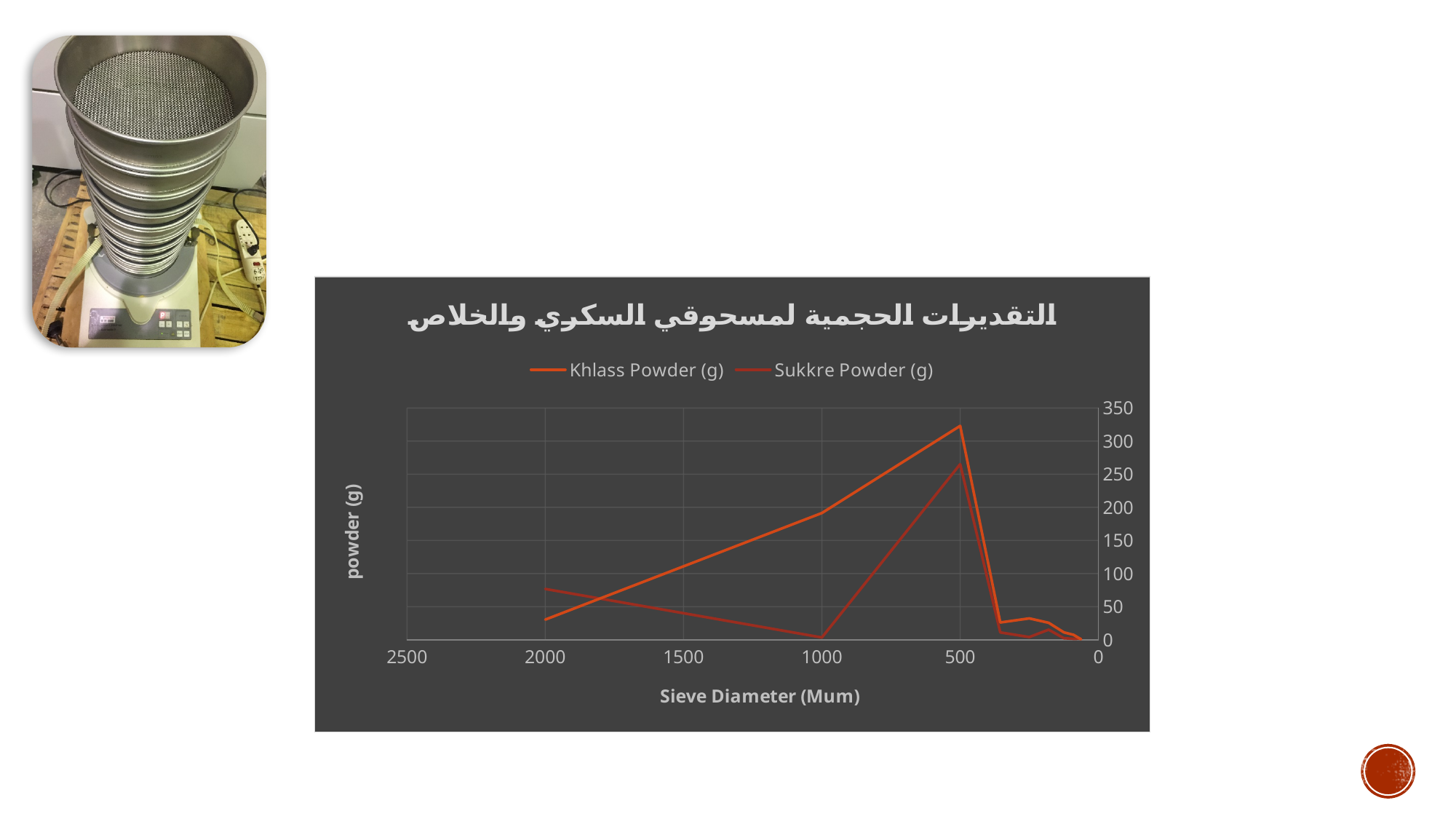
Is the lower of the two peaks at sieve diameter 500 greater or less than 200? greater At which sieve diameter does the highest plotted value on the chart occur? 500 How many tick labels are shown on the chart's x axis? 6 Is the value of the higher line at sieve diameter 1000 greater or less than 150? greater How many series does the chart's legend list? 2 What is the title of the chart's x axis? Sieve Diameter (Mum) What kind of chart is shown on the slide? line chart Is the highest value plotted on the chart greater or less than 300? greater What are the two series names in the chart's legend? Khlass Powder (g) and Sukkre Powder (g) Do the plotted values rise or fall moving from sieve diameter 500 to sieve diameter 0 along the x axis? fall